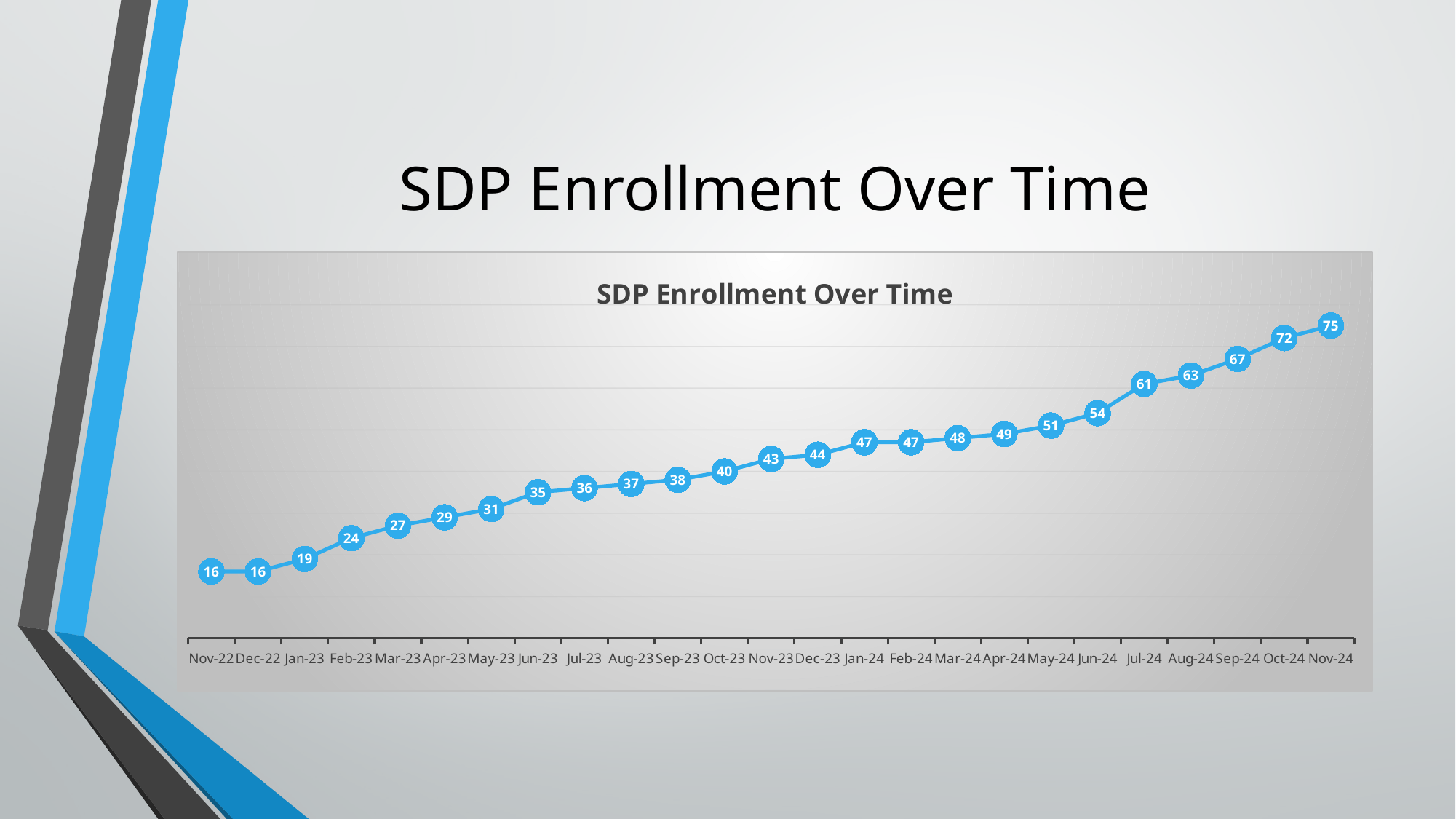
Which month has the highest SDP enrollment? Nov-24 Which is larger, the SDP enrollment for Oct-23 or for Mar-24? Mar-24 How many data points are plotted on the SDP Enrollment Over Time chart? 25 What is the SDP enrollment value for Jan-24? 47 What is the difference in SDP enrollment between Jul-24 and Jun-24? 7 What is the SDP enrollment value for Jun-23? 35 What is the SDP enrollment value for Nov-24? 75 What is the title of the chart on the slide? SDP Enrollment Over Time What is the lowest SDP enrollment value shown on the chart? 16 Do the SDP enrollment values generally rise or fall from Nov-22 to Nov-24? Rise What kind of chart is shown on the slide? Line chart What is the difference in SDP enrollment between Nov-24 and Nov-22? 59